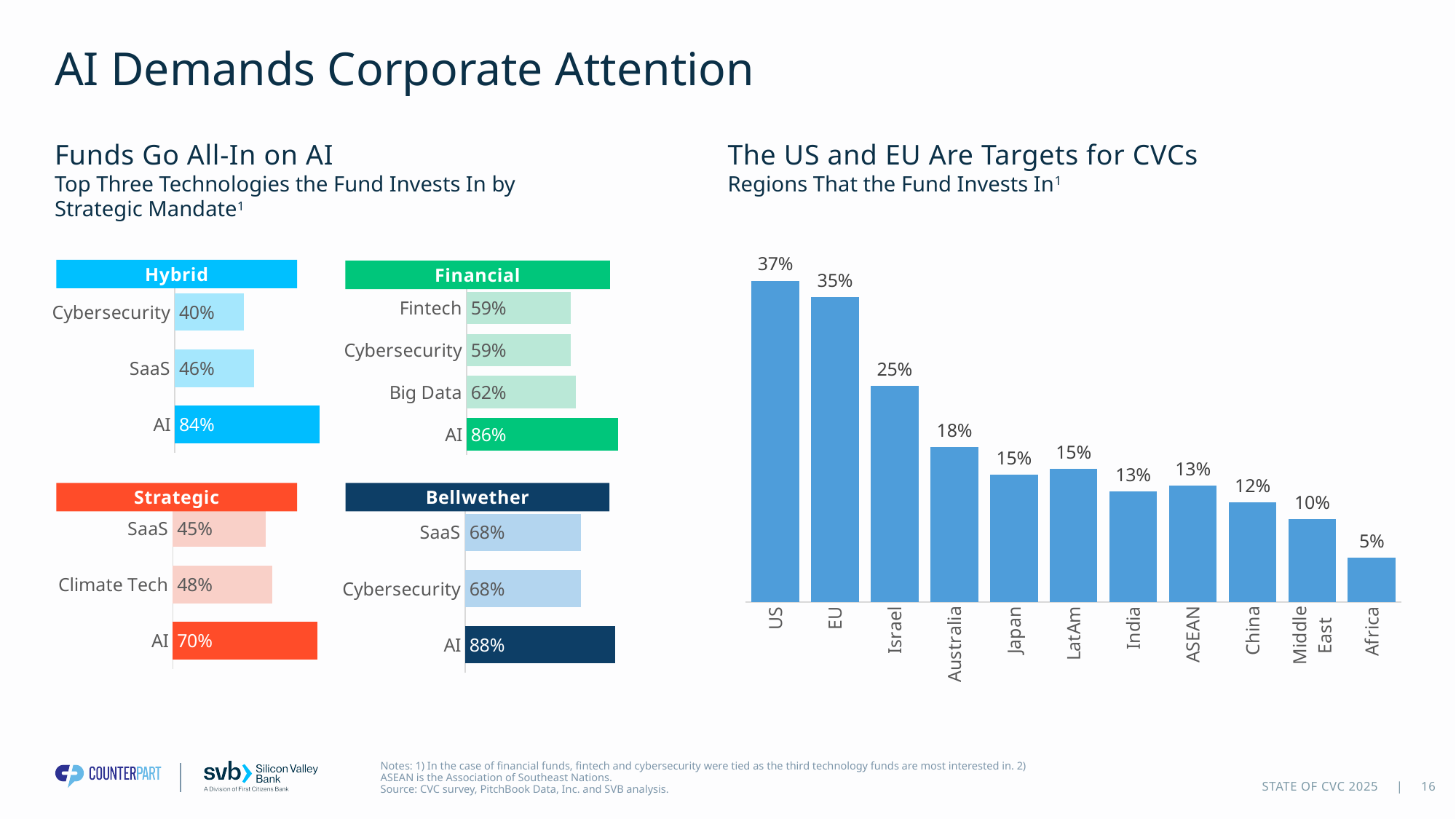
In the 'The US and EU Are Targets for CVCs' chart, what is the value for Israel? 25% In the 'The US and EU Are Targets for CVCs' chart, do the values rise or fall from left to right? fall In the 'The US and EU Are Targets for CVCs' chart, how many regions are shown? 11 What kind of chart is 'The US and EU Are Targets for CVCs'? bar chart In the 'The US and EU Are Targets for CVCs' chart, which region has the lowest value? Africa In the 'The US and EU Are Targets for CVCs' chart, which region has the highest value? US In the 'Funds Go All-In on AI' chart, what is the value for Climate Tech under the Strategic mandate? 48% In the 'The US and EU Are Targets for CVCs' chart, what is the difference between the values for US and EU? 2% In the 'Funds Go All-In on AI' chart, which is larger: AI under Hybrid or AI under Strategic? AI under Hybrid In the 'Funds Go All-In on AI' chart, what is the difference between Big Data and Fintech under the Financial mandate? 3% In the 'Funds Go All-In on AI' chart, what is the value for AI under the Bellwether mandate? 88% In the 'Funds Go All-In on AI' chart, how many strategic mandate groups are shown? 4